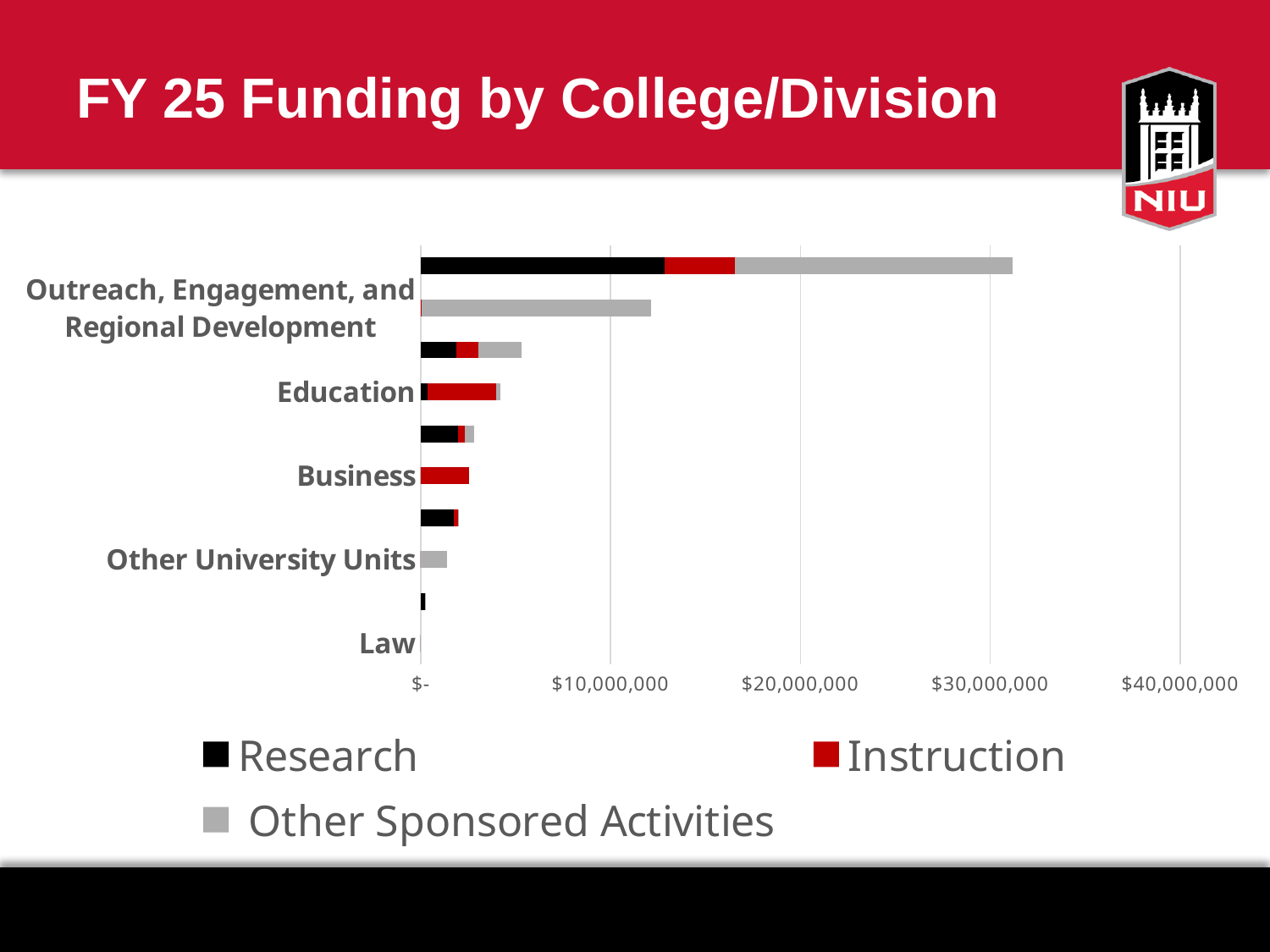
What is the title of the slide containing the chart? FY 25 Funding by College/Division Is the total funding for Education greater or less than $10,000,000? less What are the three series named in the legend? Research, Instruction, Other Sponsored Activities What kind of chart is shown on the slide? Stacked horizontal bar chart Is the total funding for Outreach, Engagement, and Regional Development greater or less than $10,000,000? greater Is the total funding for Business greater or less than $10,000,000? less Which has more total funding, Education or Business? Education Which has more total funding, Outreach, Engagement, and Regional Development or Education? Outreach, Engagement, and Regional Development How many bars are plotted on the chart? 10 Which of the labeled categories has the lowest total funding? Law How many series does the legend list? 3